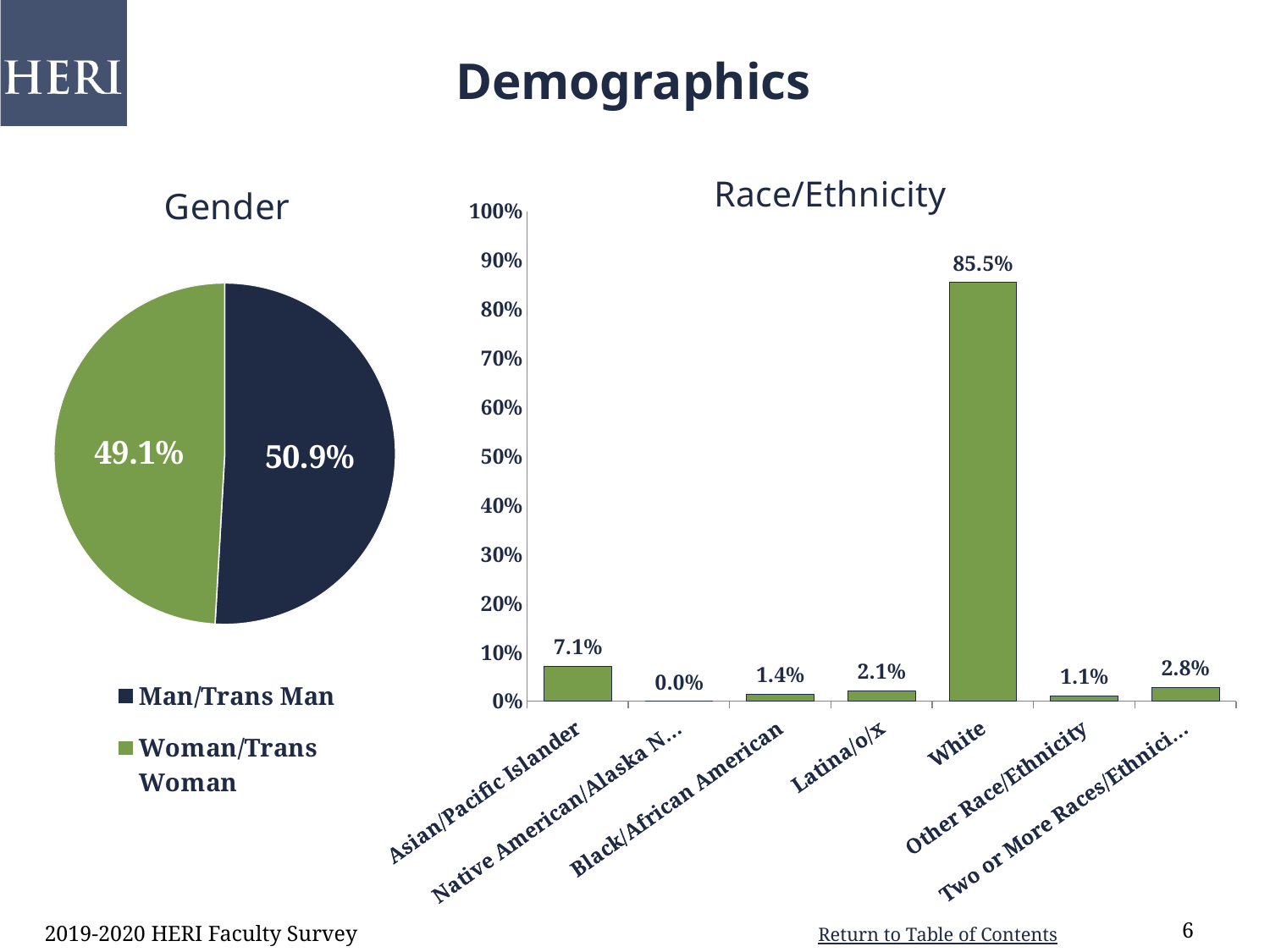
What kind of chart is the Race/Ethnicity chart? Bar chart In the Race/Ethnicity chart, which category has the highest value? White In the Race/Ethnicity chart, what is the value for White? 85.5% How many entries does the legend of the Gender chart list? 2 What kind of chart is the Gender chart? Pie chart How many categories are shown in the Race/Ethnicity chart? 7 In the Race/Ethnicity chart, what is the value for Asian/Pacific Islander? 7.1% In the Race/Ethnicity chart, what is the difference between White and Asian/Pacific Islander? 78.4% In the Gender chart, what share of respondents are Woman/Trans Woman? 49.1% In the Gender chart, what share of respondents are Man/Trans Man? 50.9% In the Gender chart, which slice is larger, Man/Trans Man or Woman/Trans Woman? Man/Trans Man In the Race/Ethnicity chart, what is the value for Black/African American? 1.4%